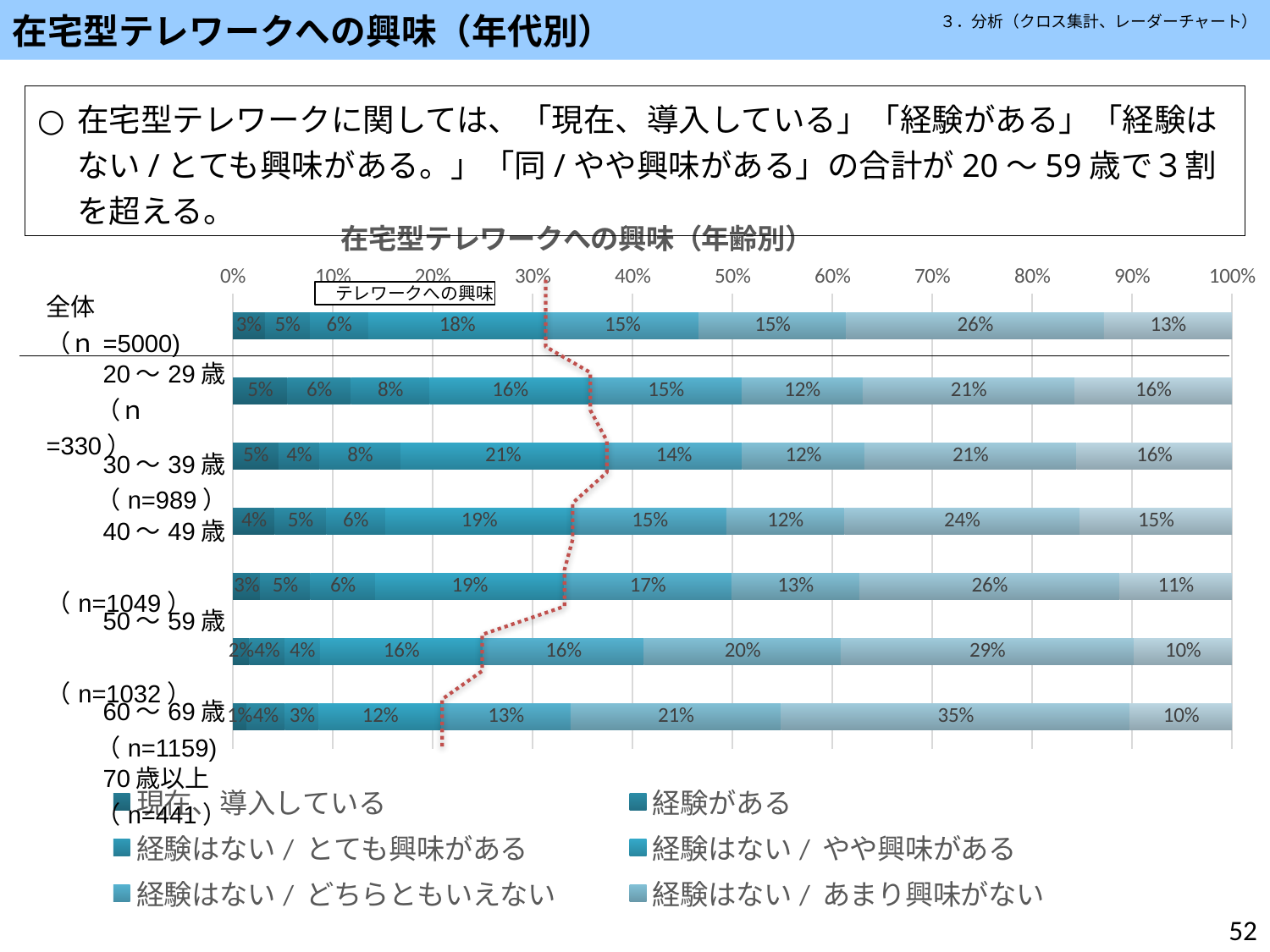
Which age group has the lowest value for 「現在、導入している」? 70歳以上 What is the title of the chart? 在宅型テレワークへの興味（年齢別） How many bars (age groups including 全体) are plotted in the chart? 7 What is the difference between the 「経験はない / やや興味がある」 value for 全体 (18%) and for 70歳以上 (12%)? 6 percentage points What is the value of the rightmost segment of the 70歳以上 bar? 10% Which age group has the highest value for 「経験はない / やや興味がある」? 30～39歳 What type of chart is shown on the slide? Stacked horizontal bar chart What is the value of the 「現在、導入している」 segment for 全体 (n=5000)? 3% What is the value of the 「経験はない / どちらともいえない」 segment for 50～59歳? 17% Which is larger, the 「経験がある」 value for 20～29歳 or for 30～39歳? 20～29歳 Does the 「経験はない / あまり興味がない」 segment rise or fall from 50～59歳 to 70歳以上? Rise What is the value of the 「経験はない / やや興味がある」 segment for 30～39歳? 21%